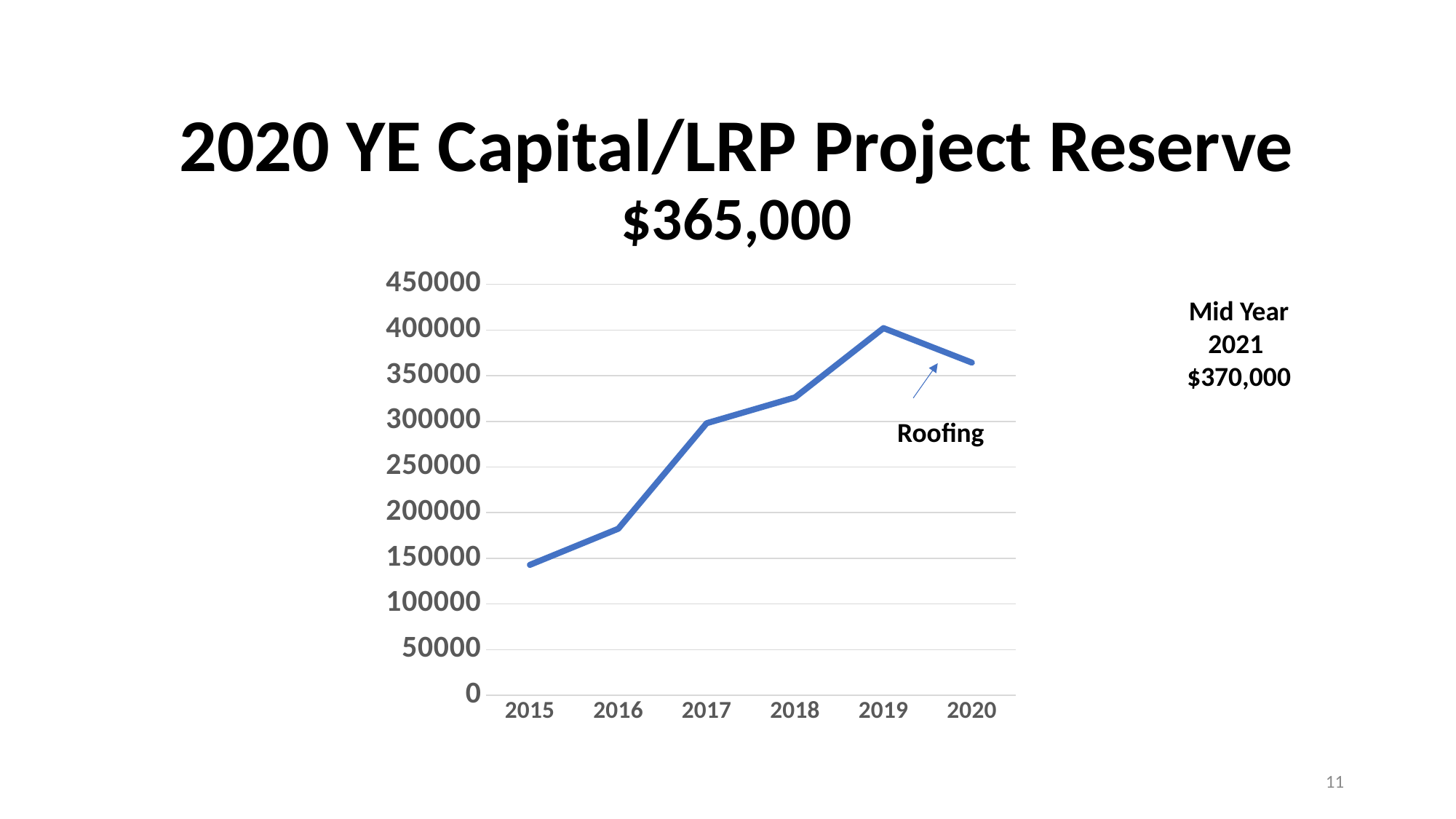
Which year has the highest reserve value on the chart? 2019 What label is attached to the arrow pointing at the drop between 2019 and 2020? Roofing Is the value for 2015 greater or less than 200000? less What type of chart is shown on the slide? line chart How does the reserve value change from 2015 to 2019? It rises Which year has the larger value, 2019 or 2020? 2019 Is the value for 2016 greater or less than 200000? less How many years are plotted on the x axis of the chart? 6 Is the value for 2018 greater or less than 300000? greater Which year has the lowest reserve value on the chart? 2015 According to the slide, what is the 2020 year-end Capital/LRP Project Reserve value? $365,000